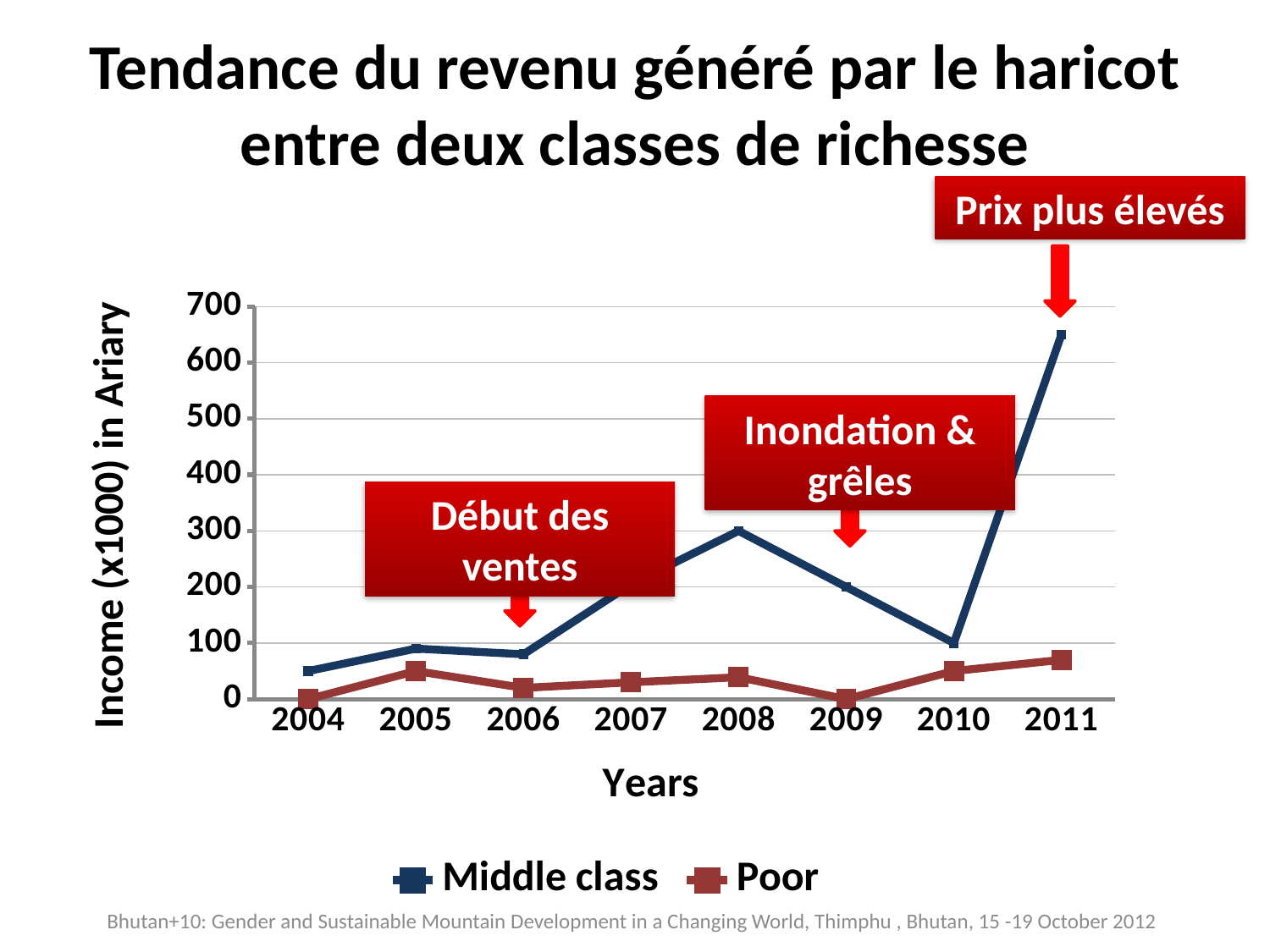
How many series does the legend list? 2 Is the Middle class value for 2008 greater or less than 200? greater What is the title of the y axis? Income (x1000) in Ariary For the Middle class series, which year has the larger value, 2008 or 2010? 2008 In which year is the Poor income highest? 2011 Is the Middle class value for 2011 greater or less than 600? greater In 2011, which series has the larger value, Middle class or Poor? Middle class In which year is the Middle class income highest? 2011 Is the Poor value for 2011 greater or less than 100? less How many years are plotted along the x axis? 8 What kind of chart is shown on the slide? line chart Does the Middle class income rise or fall from 2008 to 2010? fall